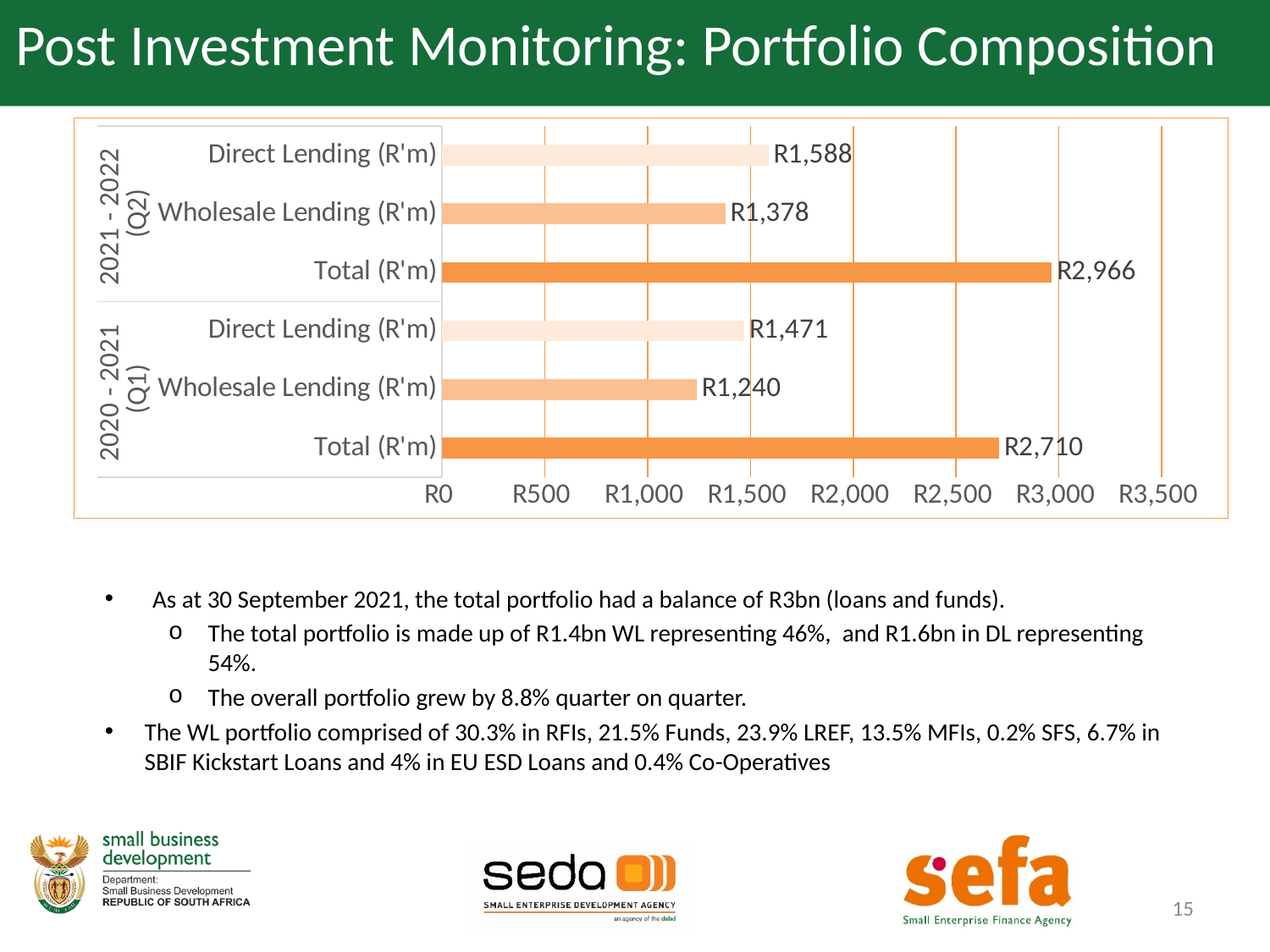
What is the Total (R'm) for 2021 - 2022 (Q2)? R2,966 Which bar has the lowest value on the chart? Wholesale Lending (R'm) for 2020 - 2021 (Q1) How many bars are plotted on the chart? 6 What is the value of Direct Lending (R'm) for 2021 - 2022 (Q2)? R1,588 What is the value of Wholesale Lending (R'm) for 2020 - 2021 (Q1)? R1,240 Which is larger: Direct Lending (R'm) in 2020 - 2021 (Q1) or Wholesale Lending (R'm) in 2021 - 2022 (Q2)? Direct Lending (R'm) in 2020 - 2021 (Q1) What is the difference between Direct Lending (R'm) and Wholesale Lending (R'm) in 2021 - 2022 (Q2)? R210 Which bar has the highest value on the chart? Total (R'm) for 2021 - 2022 (Q2) What kind of chart is shown on the slide? Bar chart What is the Total (R'm) for 2020 - 2021 (Q1)? R2,710 What is the difference between the Total (R'm) for 2021 - 2022 (Q2) and the Total (R'm) for 2020 - 2021 (Q1)? R256 Is the value for Wholesale Lending (R'm) in 2020 - 2021 (Q1) greater or less than R1,500? less